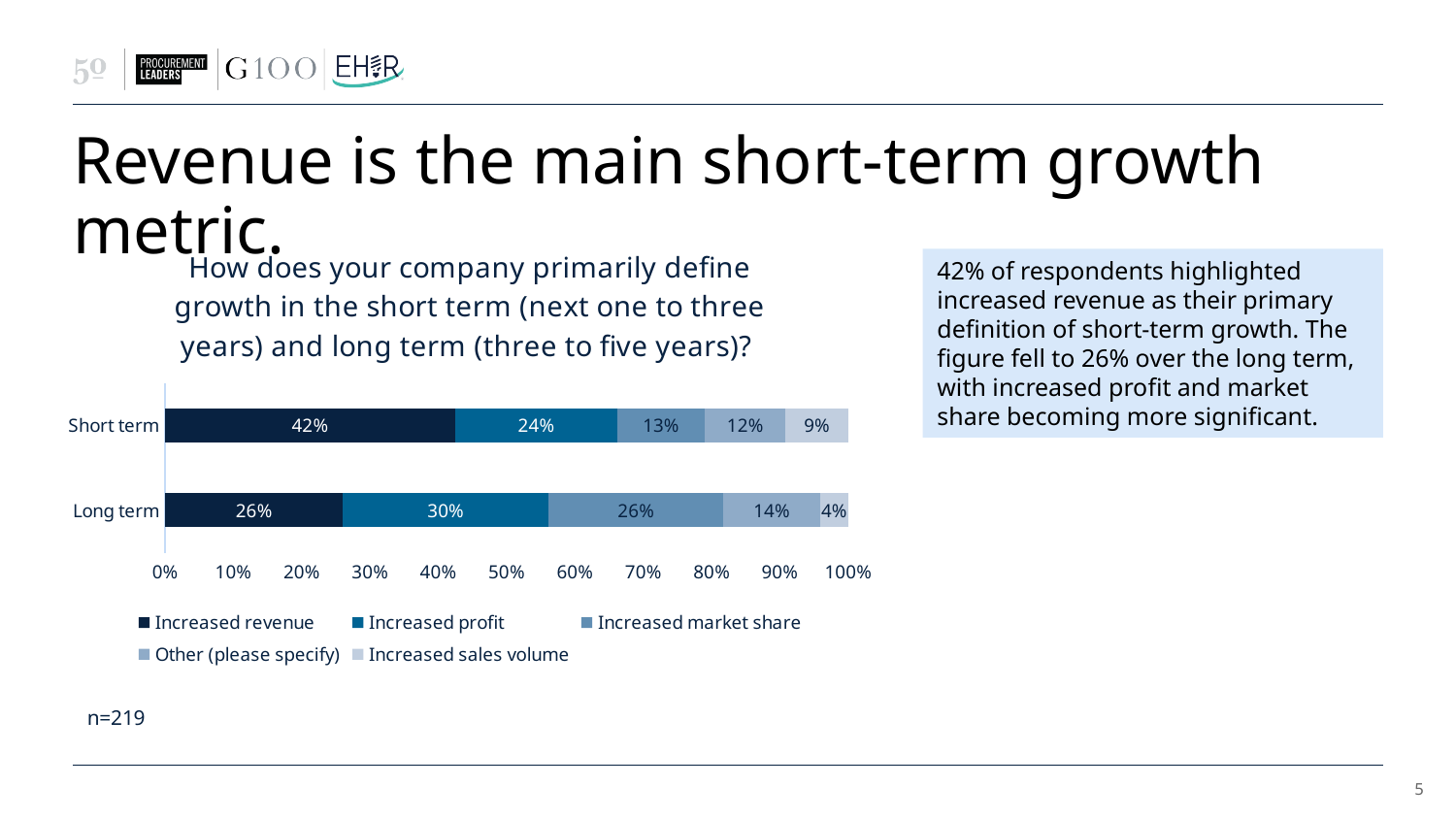
How many series does the legend list? 5 Which series has the smallest segment in the Short term bar? Increased sales volume Which series has the largest segment in the Long term bar? Increased profit What is the value for Other (please specify) in the Short term bar? 12% What is the value for Increased sales volume in the Long term bar? 4% Which is larger: Increased market share for Short term or for Long term? Long term What is the value for Increased revenue in the Short term bar? 42% What is the difference between the Increased revenue values for Short term and Long term? 16% What kind of chart is shown on the slide? Stacked bar chart What is the value for Increased profit in the Long term bar? 30% How many categories (bars) are plotted in the chart? 2 What is the total of the Long term stacked bar? 100%